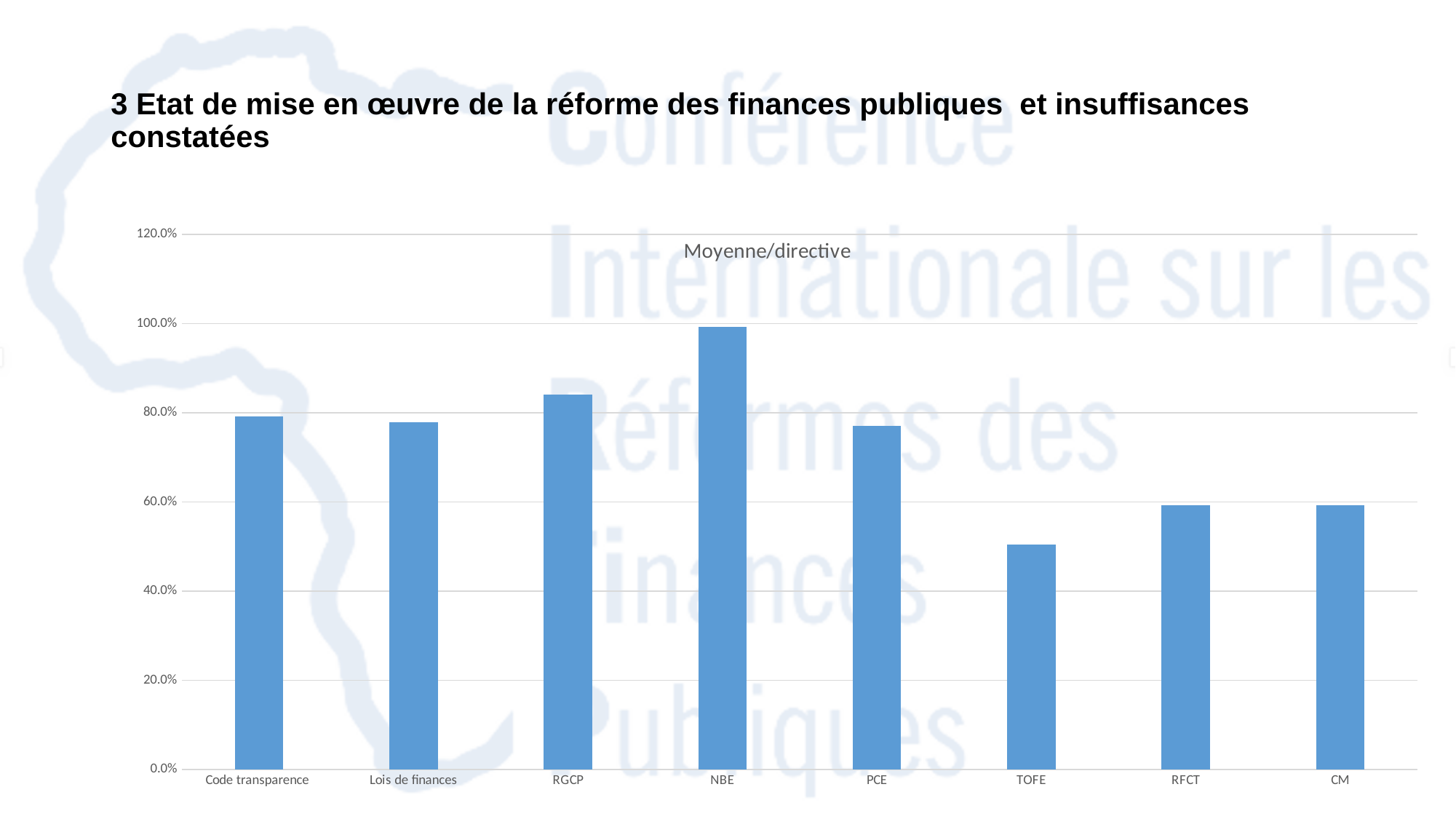
What kind of chart is shown on the slide? bar chart What is the title of the chart? Moyenne/directive Which is larger, the value for TOFE or the value for Code transparence? Code transparence Which is larger, the value for RGCP or the value for PCE? RGCP Is the value for NBE greater or less than 80.0%? greater Is the value for TOFE greater or less than 40.0%? greater Is the value for RGCP greater or less than 80.0%? greater Which category has the lowest value in the chart? TOFE Which category has the highest value in the chart? NBE How many categories are plotted on the x axis of the chart? 8